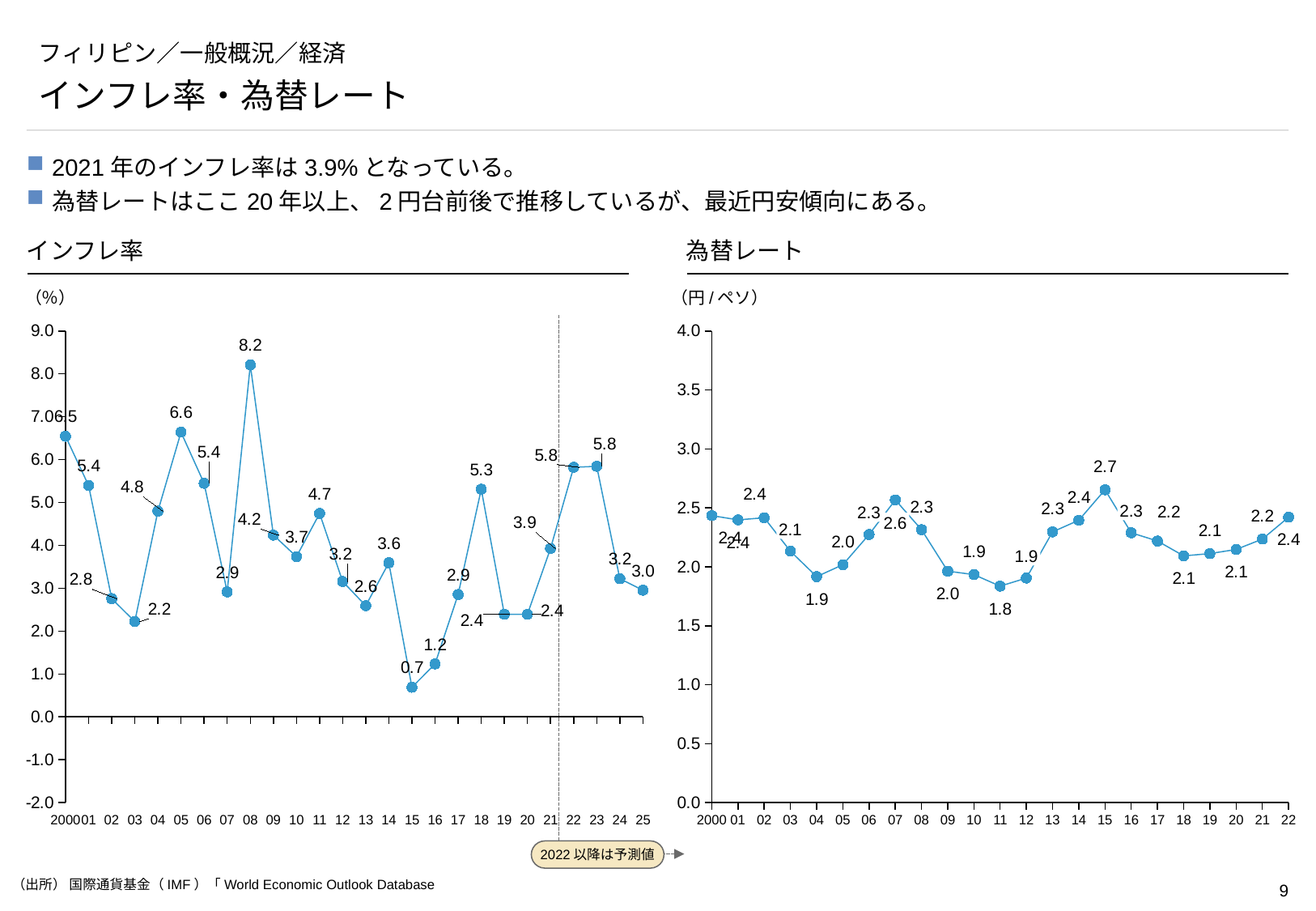
In the インフレ率 chart, what is the inflation rate for 2008? 8.2 What kind of chart is the 為替レート chart? line chart In the インフレ率 chart, which year has the lowest inflation rate? 2015 In the インフレ率 chart, what is the value for 2021? 3.9 In the 為替レート chart, do the values rise or fall from 2018 to 2022? rise In the 為替レート chart, which year has the lowest value? 2011 In the インフレ率 chart, which year has the highest inflation rate? 2008 In the 為替レート chart, what is the value for 2015? 2.7 In the インフレ率 chart, which is larger, the value for 2005 or the value for 2004? 2005 In the 為替レート chart, what is the difference between the 2015 value and the 2011 value? 0.9 What unit is shown on the y axis of the 為替レート chart? 円/ペソ In the インフレ率 chart, what is the difference between the 2018 value and the 2019 value? 2.9